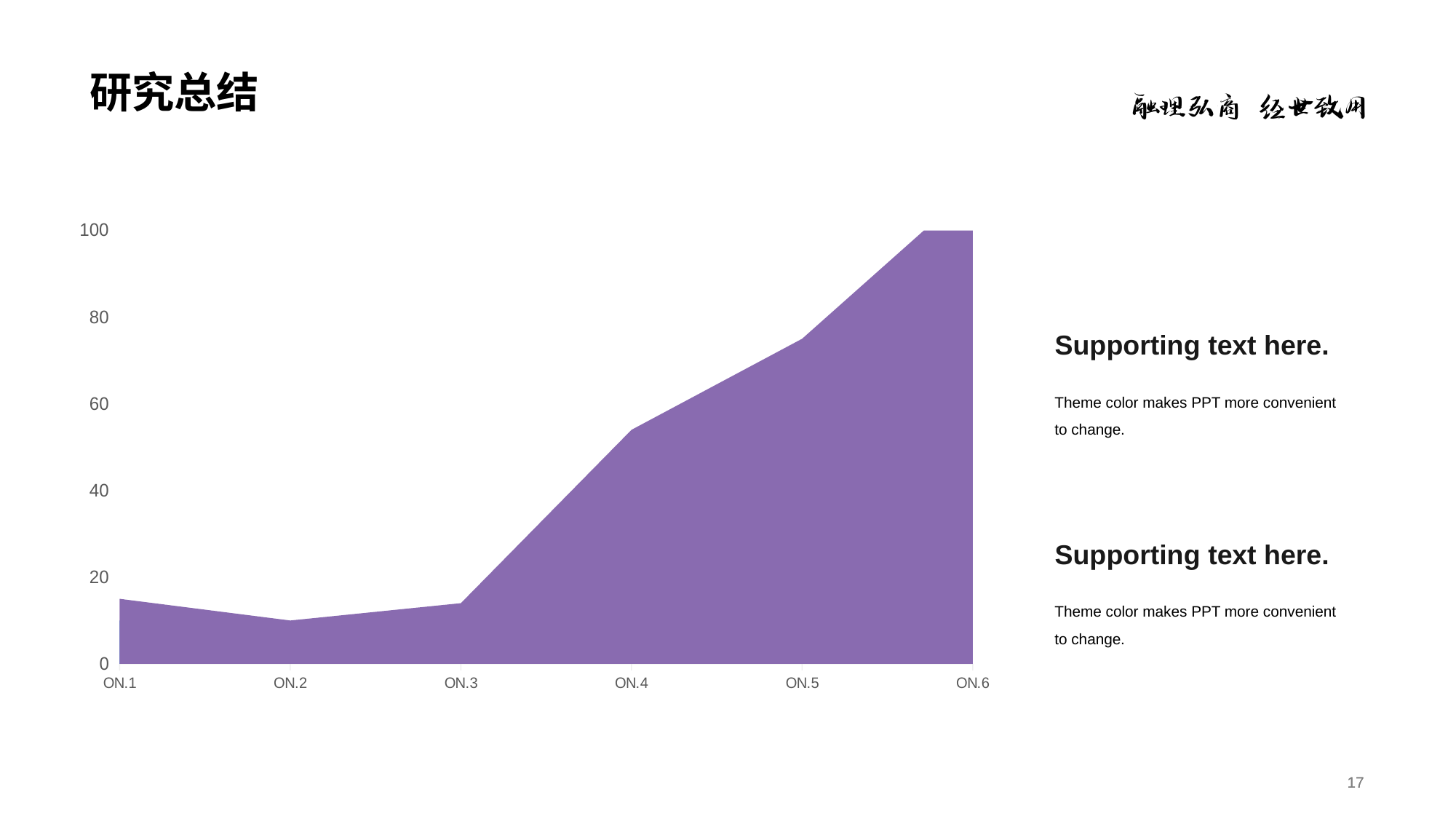
How many categories are plotted along the x axis? 6 Which category has the lowest value? ON.2 Do the values generally rise or fall from ON.3 to ON.6? rise Which is larger, the value for ON.4 or the value for ON.5? ON.5 Is the value for ON.2 greater or less than 20? less Is the value for ON.5 greater or less than 60? greater What is the highest value shown on the y axis? 100 What kind of chart is shown on the slide? area chart Is the value for ON.4 greater or less than 40? greater Which category has the highest value? ON.6